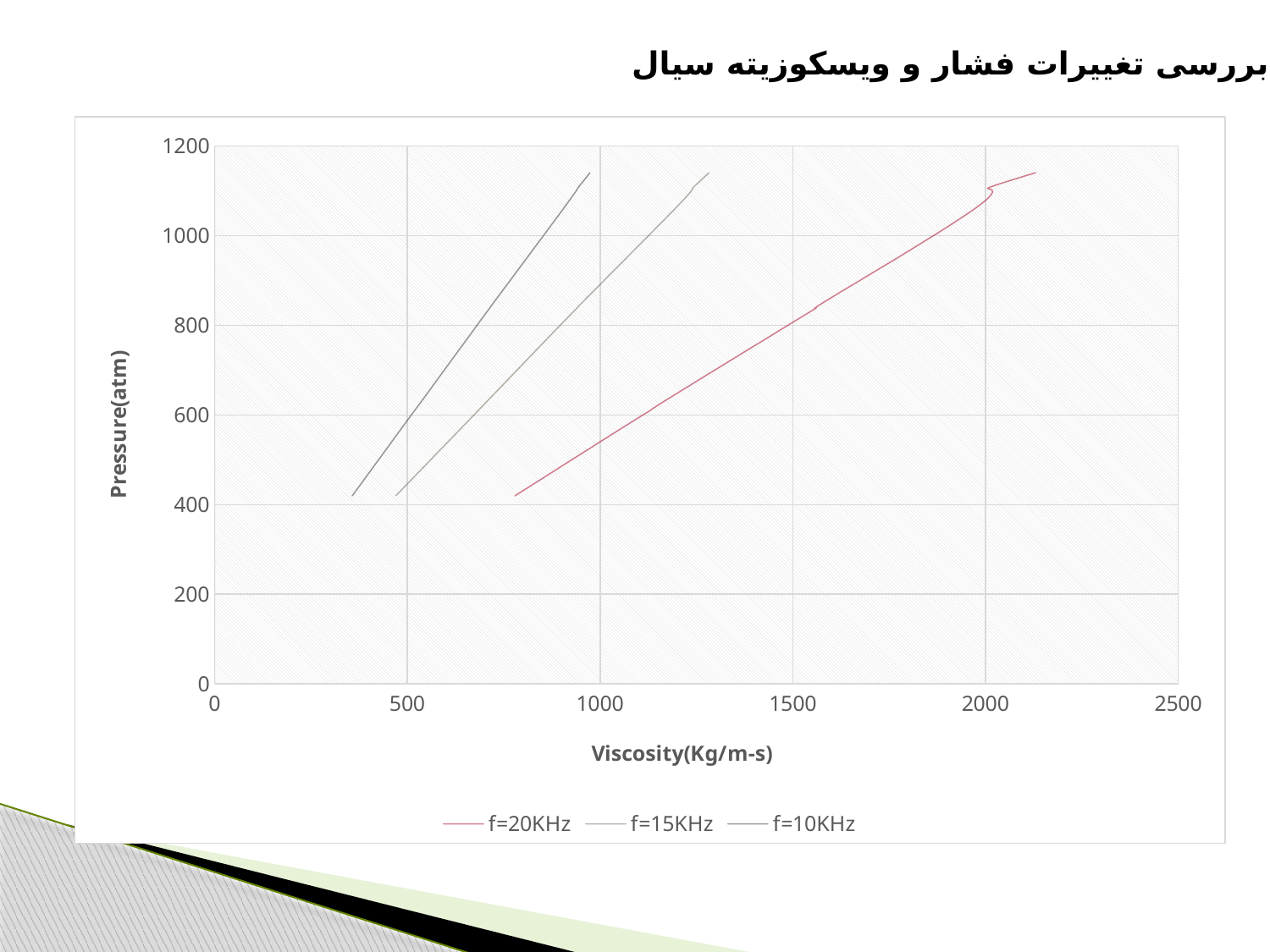
What is the label of the vertical axis? Pressure(atm) Is the maximum viscosity reached by the f=15KHz series greater or less than 1000? greater For the f=20KHz series, does pressure rise or fall as viscosity increases along the x axis? rise What kind of chart is shown on the slide? line chart Which series has the lowest viscosity values? f=10KHz What are the series names listed in the legend? f=20KHz, f=15KHz, f=10KHz At a pressure of 800 atm, which series has the larger viscosity, f=20KHz or f=10KHz? f=20KHz Which series reaches the highest viscosity values? f=20KHz Is the maximum viscosity reached by the f=10KHz series greater or less than 1000? less How many series does the legend list? 3 Is the highest pressure reached by the f=15KHz series greater or less than 1000? greater